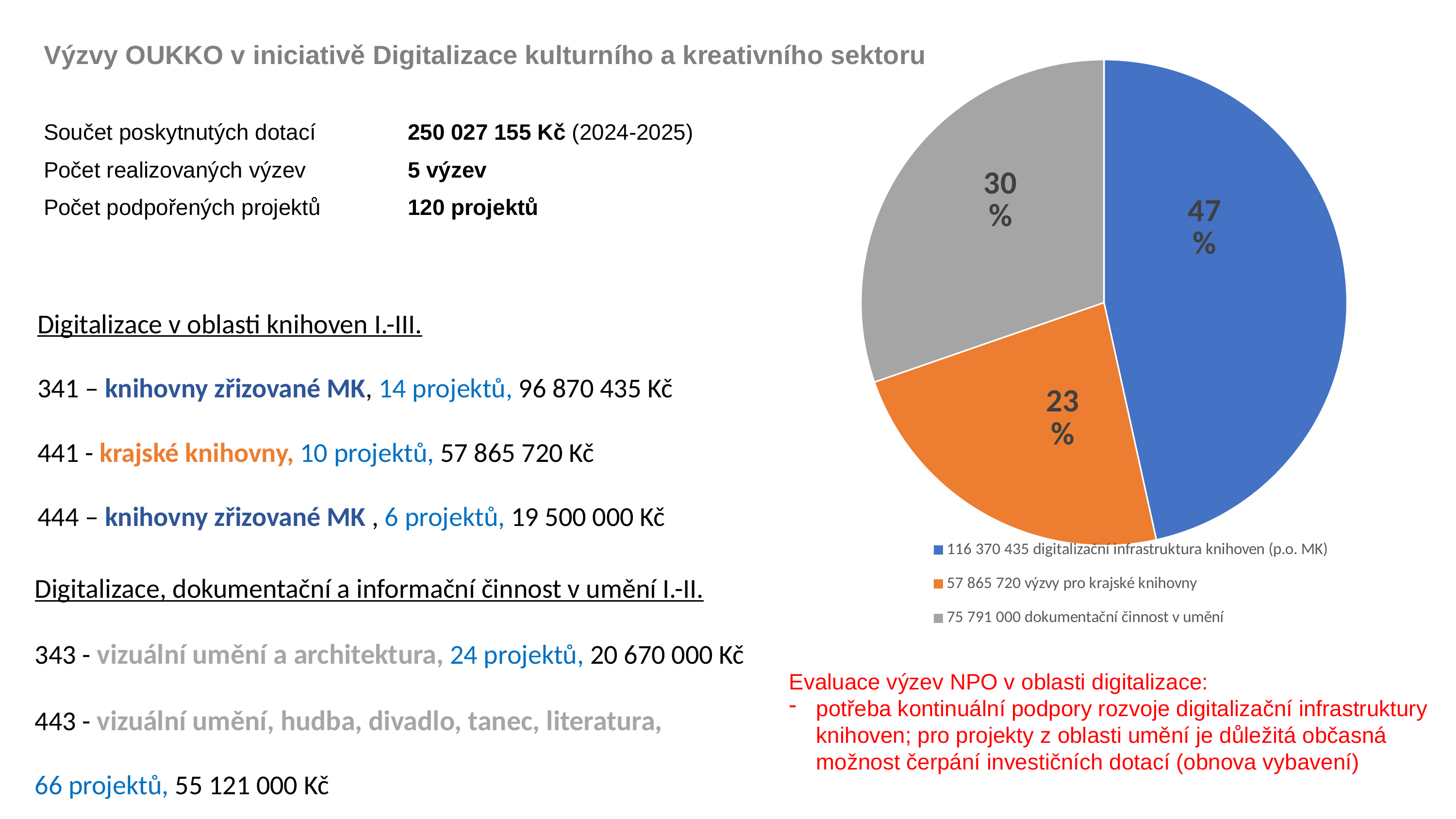
What colour is the slice for 'výzvy pro krajské knihovny' in the pie chart? orange Which is larger in the pie chart: the share for 'dokumentační činnost v umění' or the share for 'výzvy pro krajské knihovny'? dokumentační činnost v umění How many slices does the pie chart have? 3 Which slice of the pie chart is the largest? digitalizační infrastruktura knihoven (p.o. MK) What percentage share does the pie chart show for 'výzvy pro krajské knihovny'? 23% What percentage share does the pie chart show for 'dokumentační činnost v umění'? 30% What value does the legend give for 'výzvy pro krajské knihovny'? 57 865 720 What kind of chart is shown on the slide? pie chart What value does the legend give for 'dokumentační činnost v umění'? 75 791 000 What percentage share does the pie chart show for 'digitalizační infrastruktura knihoven (p.o. MK)'? 47% How many entries does the pie chart's legend list? 3 Which slice of the pie chart is the smallest? výzvy pro krajské knihovny